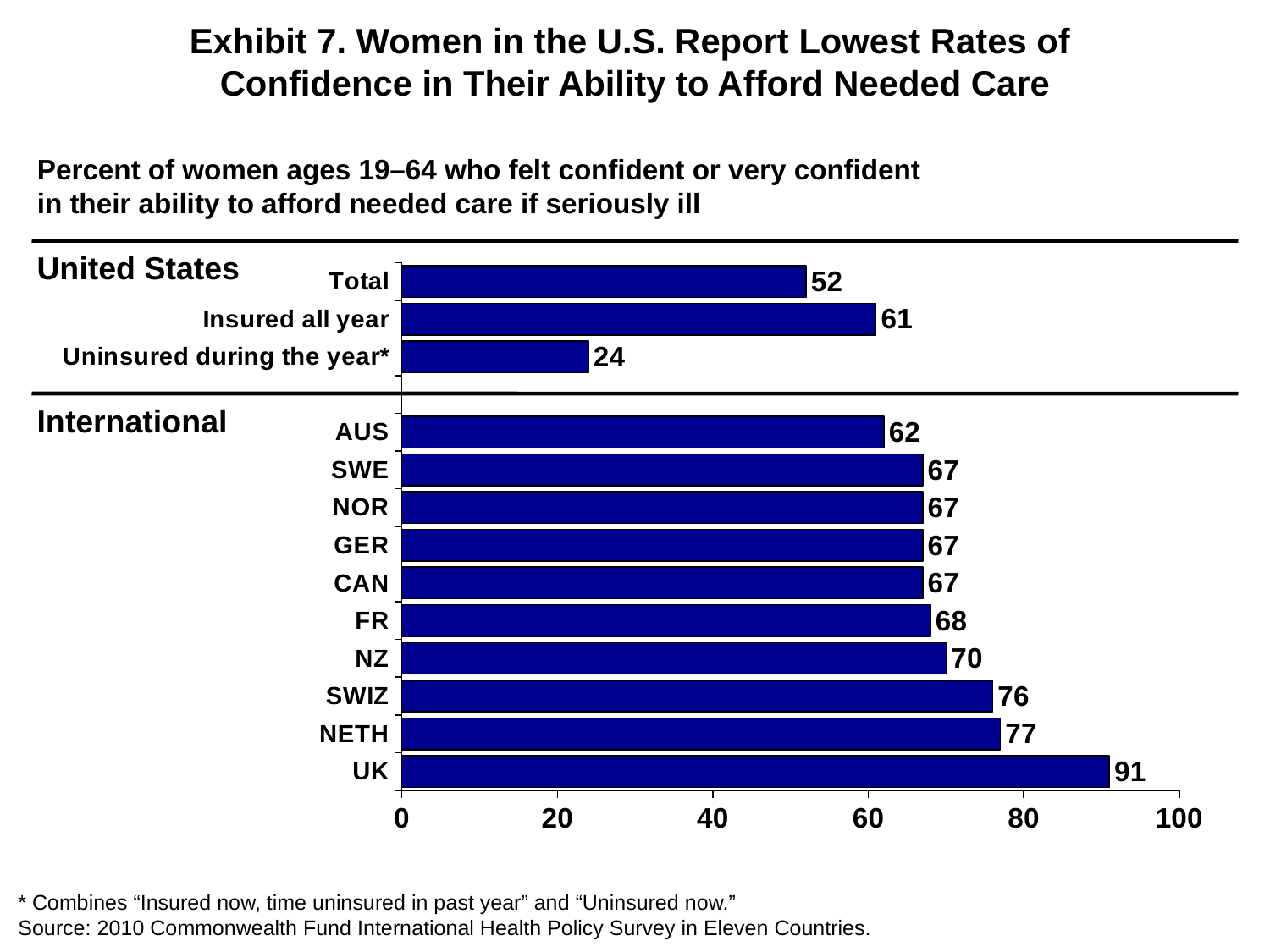
What is the title of the chart? Exhibit 7. Women in the U.S. Report Lowest Rates of Confidence in Their Ability to Afford Needed Care What is the difference between the values for UK and Total? 39 What is the value for the UK? 91 How many bars are plotted in the chart? 13 Is the value for AUS greater or less than 80? less What is the value for Insured all year? 61 What is the value for NETH? 77 Which category has the highest value? UK Which is larger, the value for SWIZ or the value for NZ? SWIZ What is the value for Uninsured during the year*? 24 What kind of chart is shown on the slide? bar chart Which category has the lowest value? Uninsured during the year*